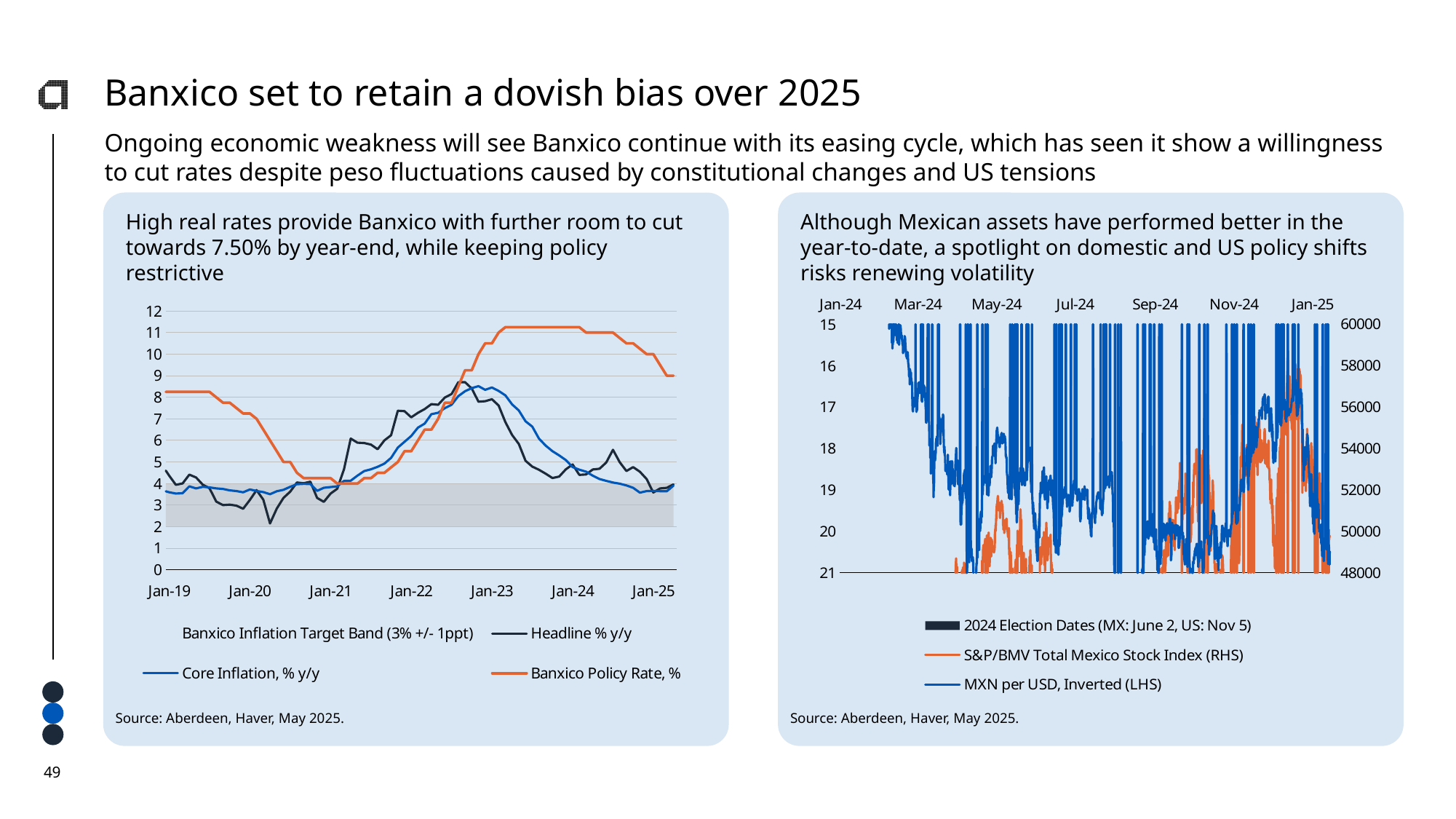
In the right chart, what is the highest value shown on the right-hand axis? 60000 How many series does the legend of the right chart list? 3 In the left chart, does the Banxico Policy Rate rise or fall between Jan-21 and Jan-23? Rise In the left chart, is the peak of the Banxico Policy Rate during 2023 greater or less than 10? greater In the left chart, is the Banxico Policy Rate at Jan-21 greater or less than 5? less What kind of chart is the right chart, titled 'Although Mexican assets have performed better in the year-to-date, a spotlight on domestic and US policy shifts risks renewing volatility'? Line chart In the right chart, which series is plotted on the right-hand axis (RHS)? S&P/BMV Total Mexico Stock Index In the left chart, does the Banxico Policy Rate rise or fall between Jan-24 and Jan-25? Fall How many series does the legend of the left chart list? 4 What kind of chart is the left chart, titled 'High real rates provide Banxico with further room to cut towards 7.50% by year-end, while keeping policy restrictive'? Line chart In the left chart, what range does the Banxico Inflation Target Band cover according to the legend? 3% +/- 1ppt In the left chart, is the Headline % y/y value at Jan-23 greater or less than 7? greater